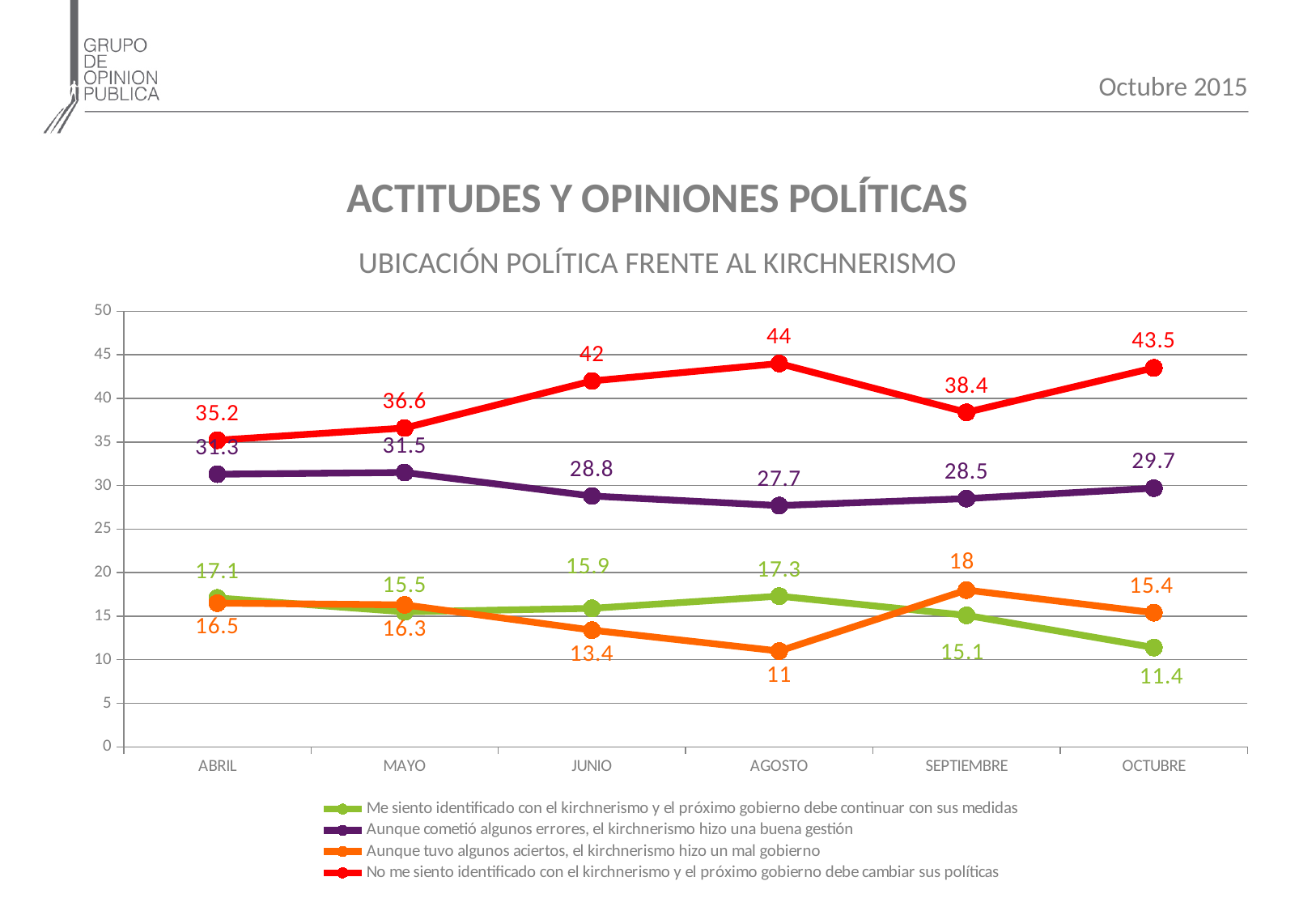
What is the value of the purple line (Aunque cometió algunos errores, el kirchnerismo hizo una buena gestión) in JUNIO? 28.8 Does the green line (Me siento identificado con el kirchnerismo...) rise or fall from AGOSTO to OCTUBRE? Fall What is the value of the red line (No me siento identificado con el kirchnerismo y el próximo gobierno debe cambiar sus políticas) in AGOSTO? 44 In which month does the green line (Me siento identificado con el kirchnerismo...) reach its lowest value? OCTUBRE How many series does the legend list? 4 What is the difference between the red line's value in OCTUBRE (43.5) and its value in ABRIL (35.2)? 8.3 What is the subtitle of the chart? UBICACIÓN POLÍTICA FRENTE AL KIRCHNERISMO In which month does the red line (No me siento identificado con el kirchnerismo...) reach its highest value? AGOSTO What type of chart is shown on the slide? Line chart In OCTUBRE, which is larger: the orange line (Aunque tuvo algunos aciertos...) or the green line (Me siento identificado...)? The orange line (15.4) How many months are plotted along the x axis? 6 What is the value of the orange line (Aunque tuvo algunos aciertos, el kirchnerismo hizo un mal gobierno) in SEPTIEMBRE? 18